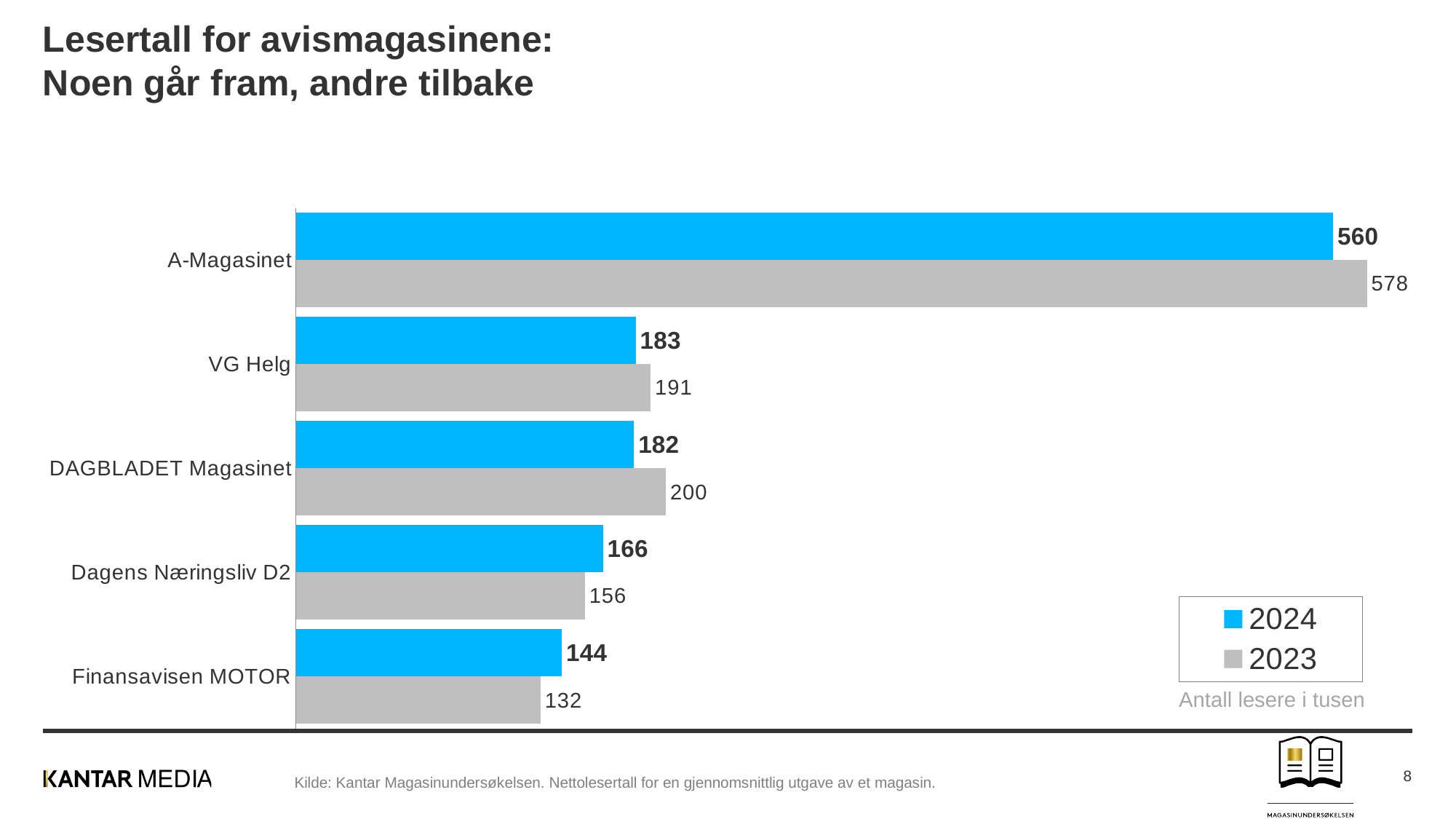
What is the 2024 value for Finansavisen MOTOR? 144 How many magazines are shown in the chart? 5 Which magazine has the highest 2024 value? A-Magasinet What is the 2024 value for A-Magasinet? 560 What is the 2023 value for DAGBLADET Magasinet? 200 What is the difference between the 2023 and 2024 values for A-Magasinet? 18 What kind of chart is shown on the slide? Bar chart Which magazine has the lowest 2023 value? Finansavisen MOTOR How many series does the legend list? 2 Which is larger for VG Helg: the 2024 value or the 2023 value? 2023 What is the difference between the 2024 and 2023 values for Dagens Næringsliv D2? 10 Which colour represents 2024 in the chart? Blue